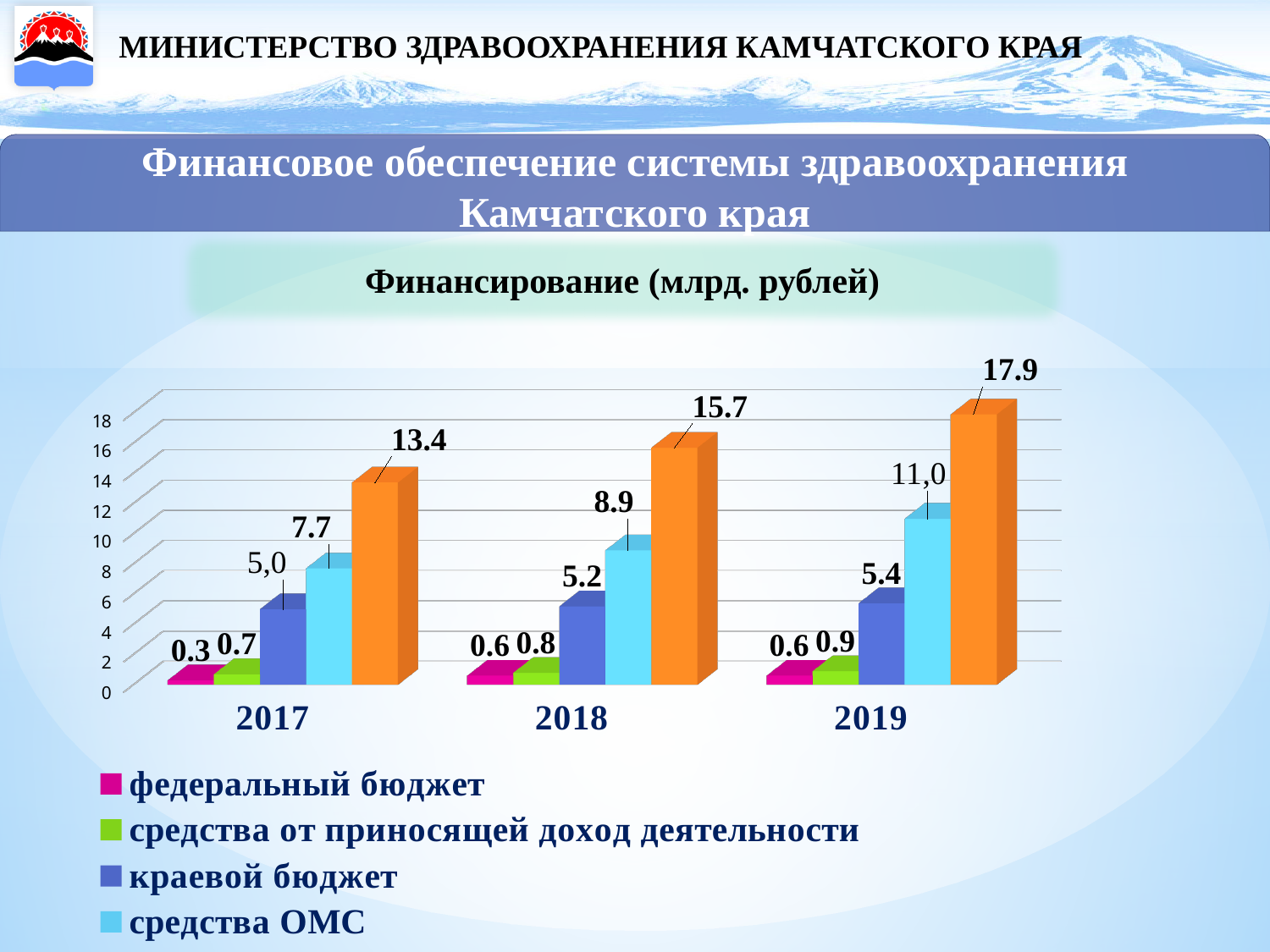
How many years are shown on the x axis of the chart? 3 Do the values for средства ОМС rise or fall from 2017 to 2019? rise What is the difference between the orange bar values for 2019 and 2017? 4.5 What is the value for федеральный бюджет in 2017? 0.3 What is the value for средства от приносящей доход деятельности in 2019? 0.9 Which is larger in 2018: краевой бюджет or средства ОМС? средства ОМС What is the value for средства ОМС in 2018? 8.9 What kind of chart is shown on the slide? bar chart How many series does the legend list? 4 What is the value for краевой бюджет in 2019? 5.4 What is the value of the tallest (orange) bar in 2019? 17.9 In which year is the value for средства ОМС the highest? 2019